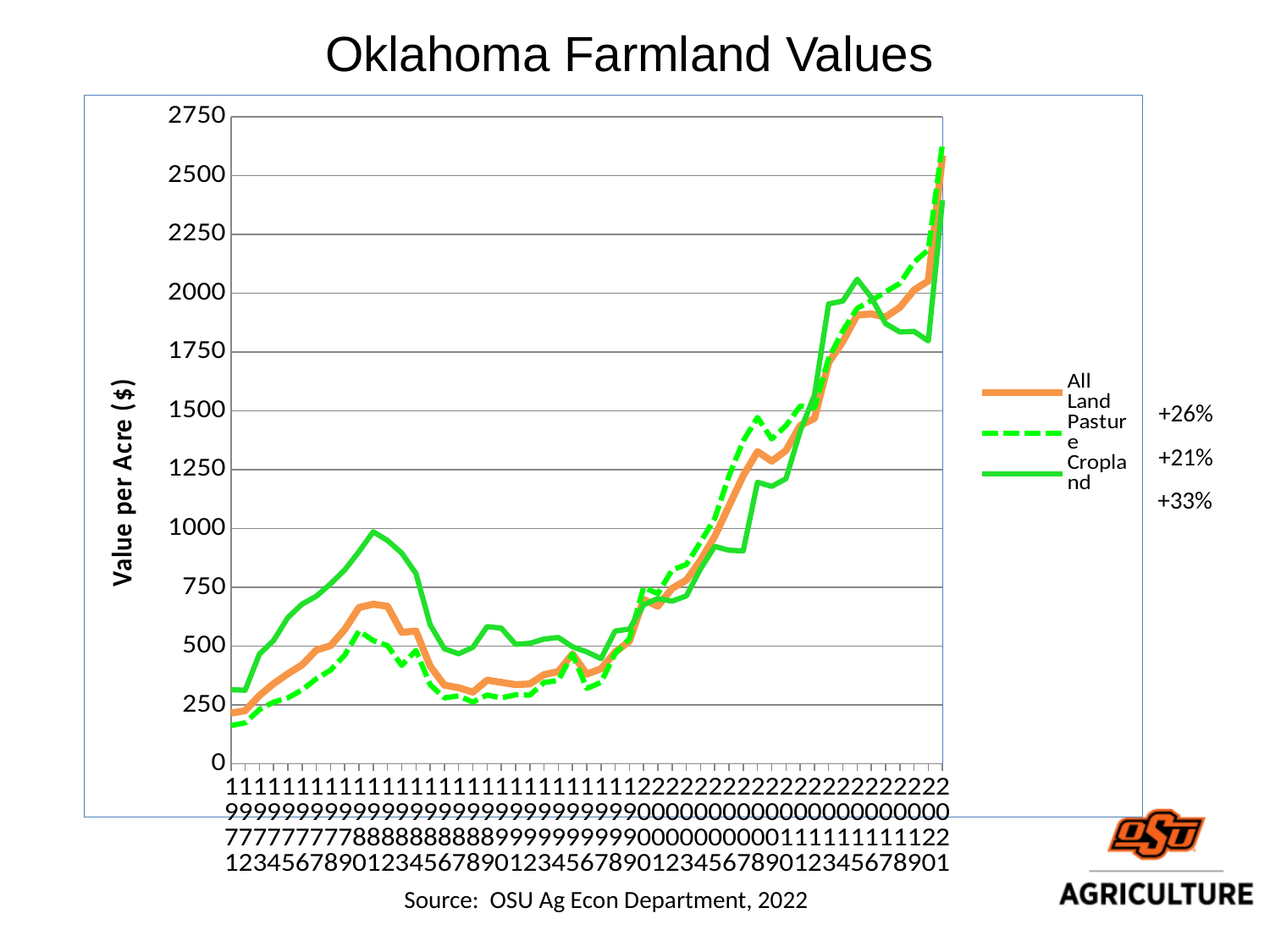
Which series has the highest value per acre in 1981? Cropland What percentage is shown next to the Cropland legend entry? +33% Is the All Land value in 2001 greater or less than 1000? less Overall, do the All Land values rise or fall from 2001 to 2021? Rise Which is larger in 1975, the Cropland value or the Pasture value? Cropland Which series has the lowest value per acre in 1981? Pasture How many series does the legend list? 3 What type of chart is shown on the slide? Line chart What is the label on the vertical axis? Value per Acre ($) Is the Pasture value in 1971 greater or less than 250? less Is the All Land value in 2021 greater or less than 2250? greater